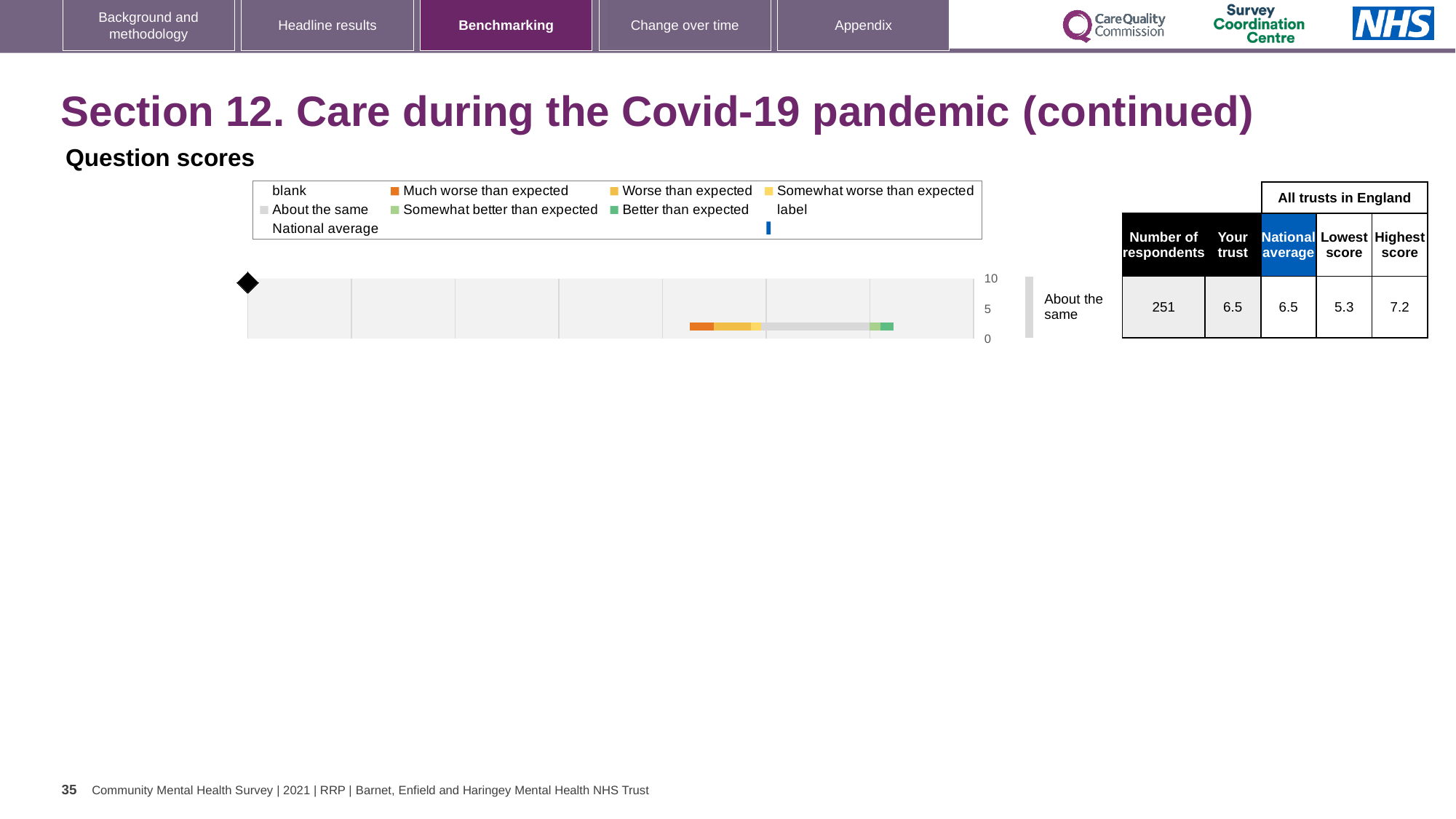
How many respondents are shown for this question? 251 What is the difference between the highest score (7.2) and the 'Your trust' score (6.5)? 0.7 What is the difference between the highest score (7.2) and the lowest score (5.3)? 1.9 What is the highest score among all trusts in England for this question? 7.2 Which colour in the legend represents 'Much worse than expected'? orange What is the lowest score among all trusts in England for this question? 5.3 What is the highest value shown on the chart's numeric axis? 10 What is the 'Your trust' score shown for the question? 6.5 What kind of chart is shown on the slide? bar chart What is the national average score shown for the question? 6.5 How many question bars are plotted on the chart? 1 Which is larger, the highest score or the lowest score among all trusts in England? highest score